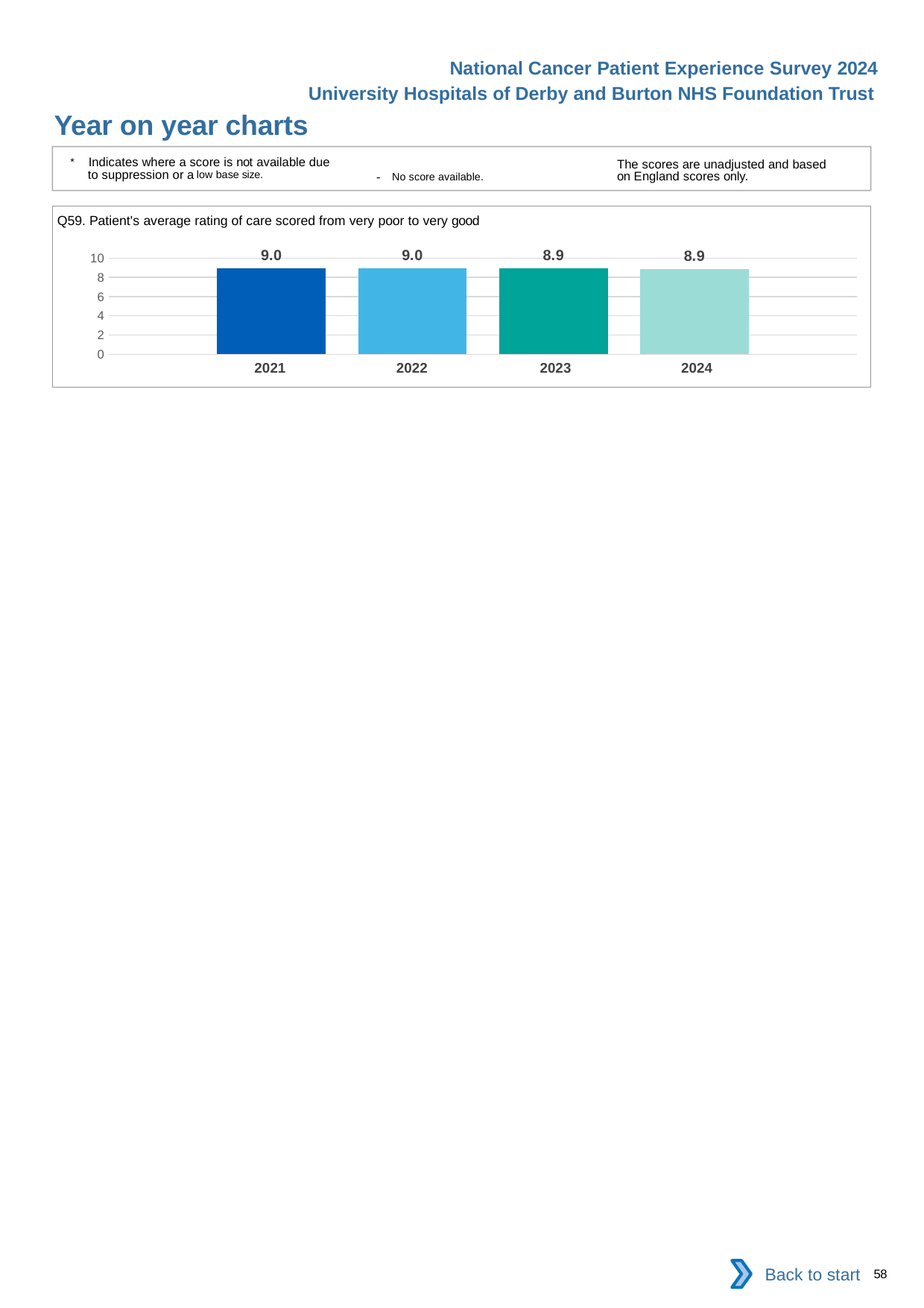
What is the value for 2022? 9.0 What is the title of the chart? Q59. Patient's average rating of care scored from very poor to very good Is the value for 2024 greater or less than 8? greater What is the highest value shown on the y axis? 10 What is the value for 2021? 9.0 How many years are shown on the chart? 4 Do the values rise or fall from 2021 to 2024? fall What is the difference between the values for 2021 and 2024? 0.1 Which is larger, the value for 2022 or the value for 2023? 2022 What kind of chart is shown? bar chart What is the value for 2024? 8.9 What is the value for 2023? 8.9